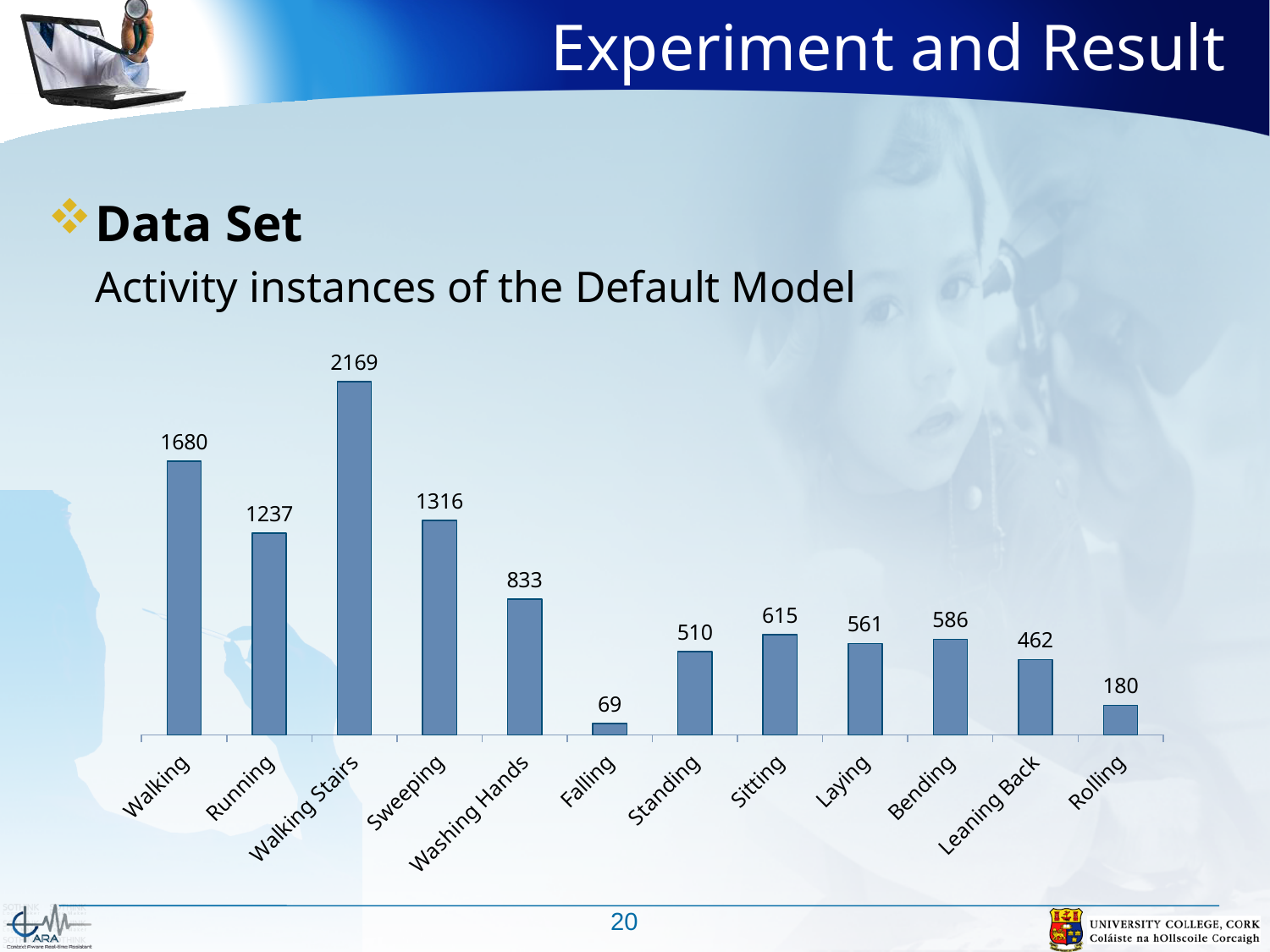
What is the difference between the values for Sitting and Standing? 105 Which is larger, the value for Sweeping or the value for Running? Sweeping How many activity categories are shown on the x axis? 12 What is the value for Washing Hands? 833 What is the value for Leaning Back? 462 Which activity has the highest number of instances? Walking Stairs What is the value for Rolling? 180 What kind of chart is shown on the slide? Bar chart Which is larger, the value for Bending or the value for Laying? Bending How many activity instances are shown for Walking Stairs? 2169 What is the difference between the values for Walking and Running? 443 Which activity has the lowest number of instances? Falling